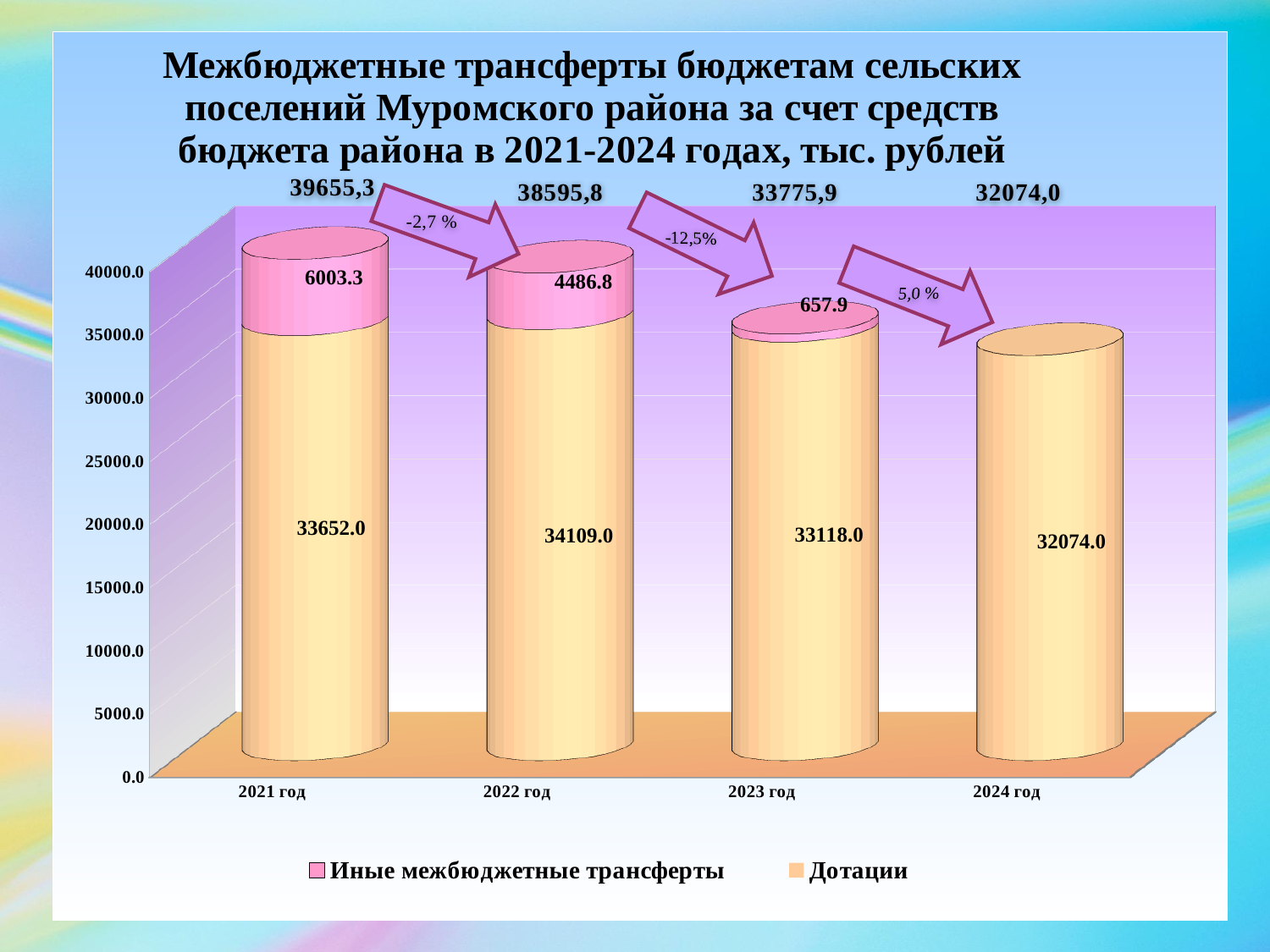
What is the value of Дотации for 2022 год? 34109.0 What is the value of Иные межбюджетные трансферты for 2021 год? 6003.3 How many series does the legend list? 2 Which year has the lowest value of Иные межбюджетные трансферты among the years where it is labelled? 2023 год What is the value of Иные межбюджетные трансферты for 2023 год? 657.9 Do the total values printed above the bars rise or fall from 2021 год to 2024 год? fall What is the total of the stacked bar for 2021 год, as printed above it? 39655,3 What is the difference between the Дотации values for 2022 год and 2023 год? 991.0 How many years are shown on the x axis? 4 Which year has the highest value of Дотации? 2022 год Which is larger: Дотации for 2021 год or Дотации for 2024 год? 2021 год What is the value of Дотации for 2024 год? 32074.0